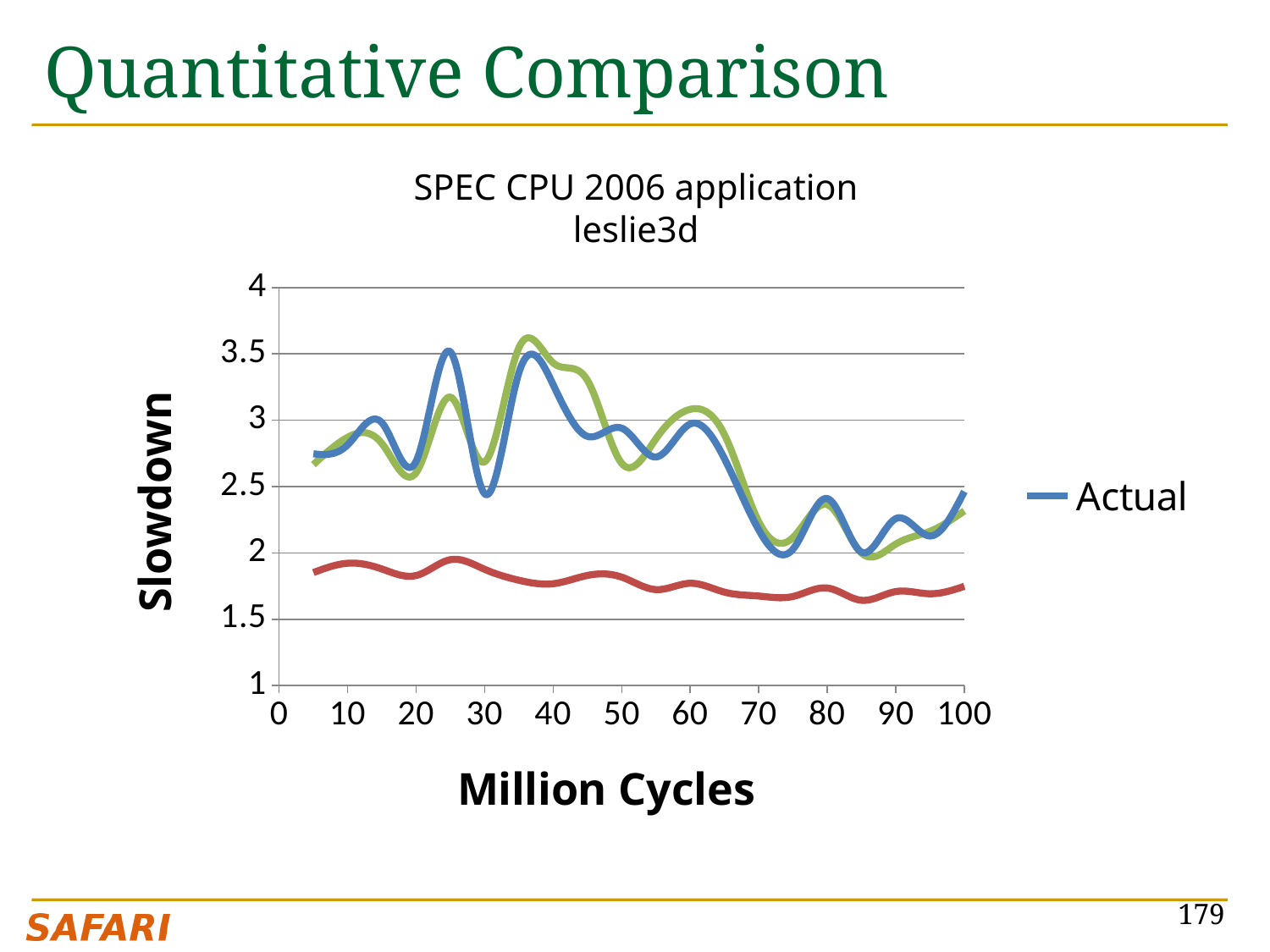
At 50 million cycles, is the Actual line higher or lower than the red line? higher Does the Actual line rise or fall between 60 and 75 million cycles? fall How many series does the legend list? 1 Is the value of the Actual line at 40 million cycles greater or less than 3? greater Is the value of the Actual line at 30 million cycles greater or less than 3? less What is the title of the chart? SPEC CPU 2006 application leslie3d Is the value of the Actual line at 75 million cycles greater or less than 2.5? less What kind of chart is shown on the slide? line chart Does the Actual line rise or fall between 5 and 15 million cycles? rise What is the label of the y axis? Slowdown